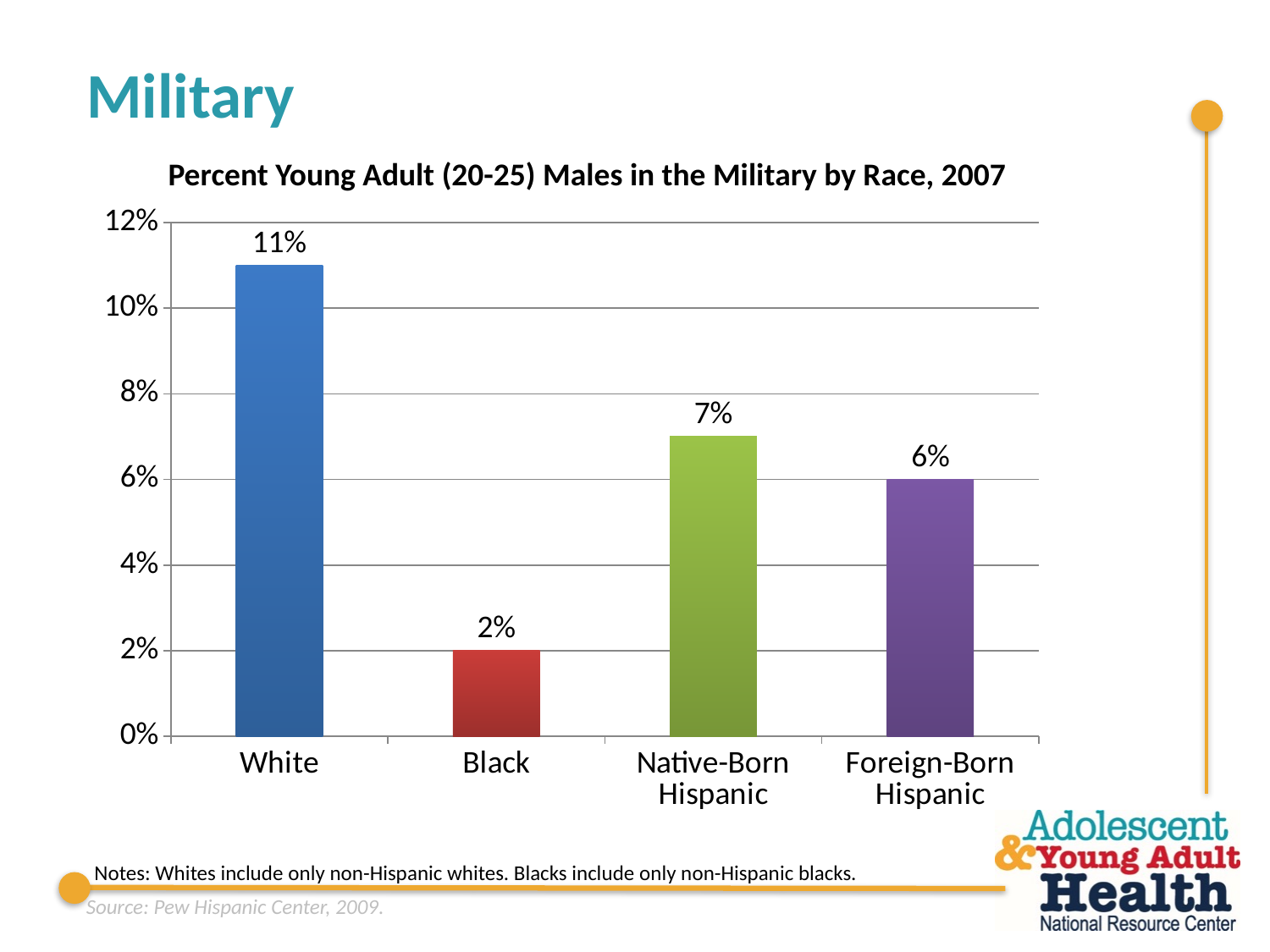
What is the title of the chart? Percent Young Adult (20-25) Males in the Military by Race, 2007 What is the value for Native-Born Hispanic? 7% Which category has the lowest value? Black What is the value for Black? 2% How many categories are shown on the x axis? 4 What is the difference between the values for Native-Born Hispanic and Foreign-Born Hispanic? 1% What is the difference between the values for White and Black? 9% What is the value for Foreign-Born Hispanic? 6% Which is larger, the value for Native-Born Hispanic or the value for Black? Native-Born Hispanic What kind of chart is this? Bar chart What is the value for White? 11% Which category has the highest value? White